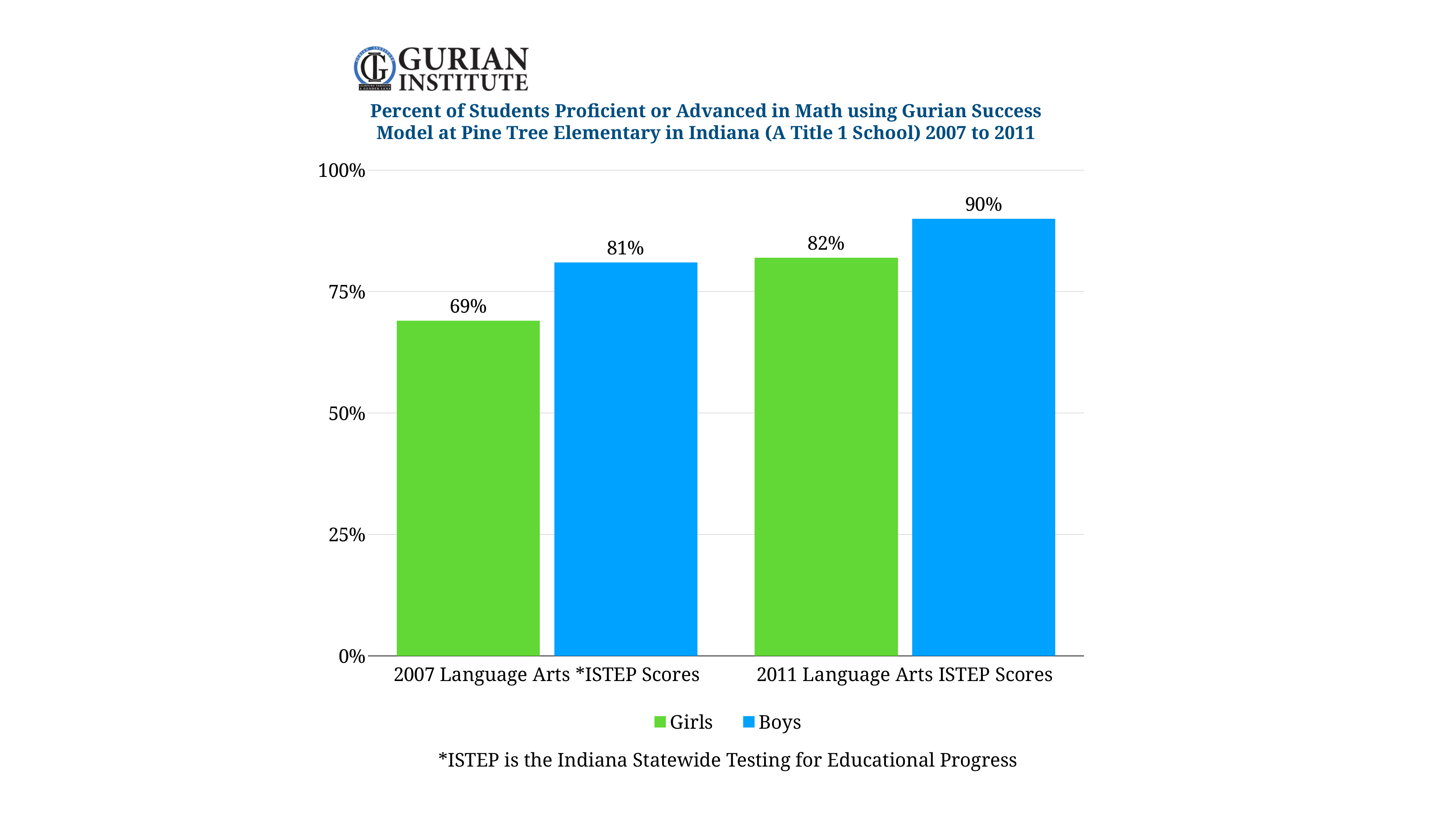
Which is larger in 2011 Language Arts ISTEP Scores, Girls or Boys? Boys What is the value for Boys in 2011 Language Arts ISTEP Scores? 90% What kind of chart is shown on the slide? Bar chart Which bar has the lowest value on the chart? Girls, 2007 Language Arts *ISTEP Scores How many series does the legend list? 2 What is the value for Boys in 2007 Language Arts *ISTEP Scores? 81% What is the value for Girls in 2011 Language Arts ISTEP Scores? 82% What is the difference between the Boys value and the Girls value in 2007 Language Arts *ISTEP Scores? 12% By how much did the Girls value increase from 2007 to 2011? 13% What is the value for Girls in 2007 Language Arts *ISTEP Scores? 69% Which bar has the highest value on the chart? Boys, 2011 Language Arts ISTEP Scores Which colour represents Girls in the chart? Green